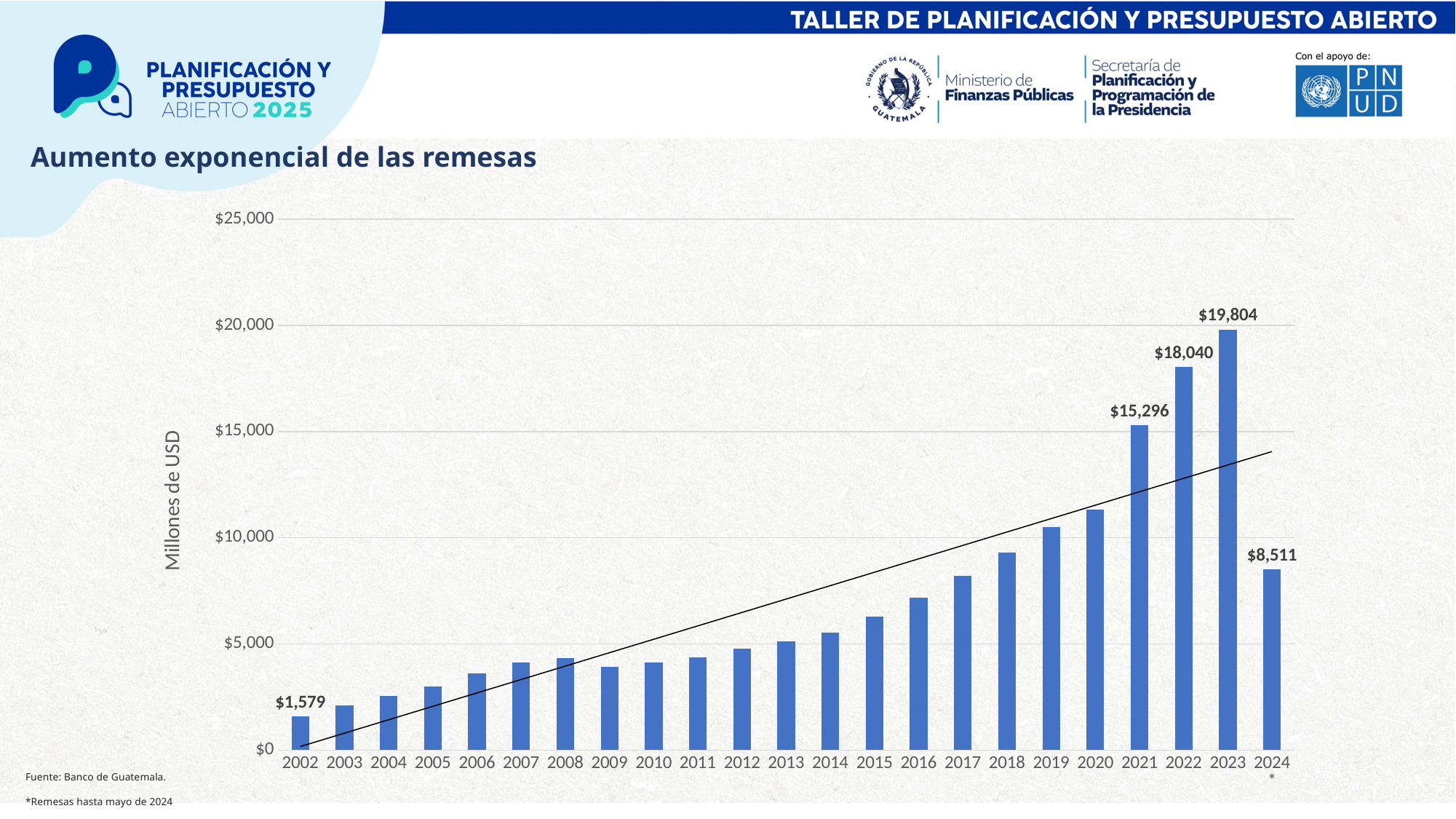
Which year has the lowest value? 2002 What is the difference between the values for 2023 and 2022? $1,764 Which year has the highest value? 2023 How many years are shown on the x axis? 23 What is the value for 2002? $1,579 Which is larger, the value for 2021 or the value for 2024? 2021 What kind of chart is shown on the slide? bar chart What is the value for 2022? $18,040 What is the value for 2023? $19,804 Is the value for 2018 greater or less than $10,000? less Is the value for 2016 greater or less than $5,000? greater What is the label of the vertical axis? Millones de USD